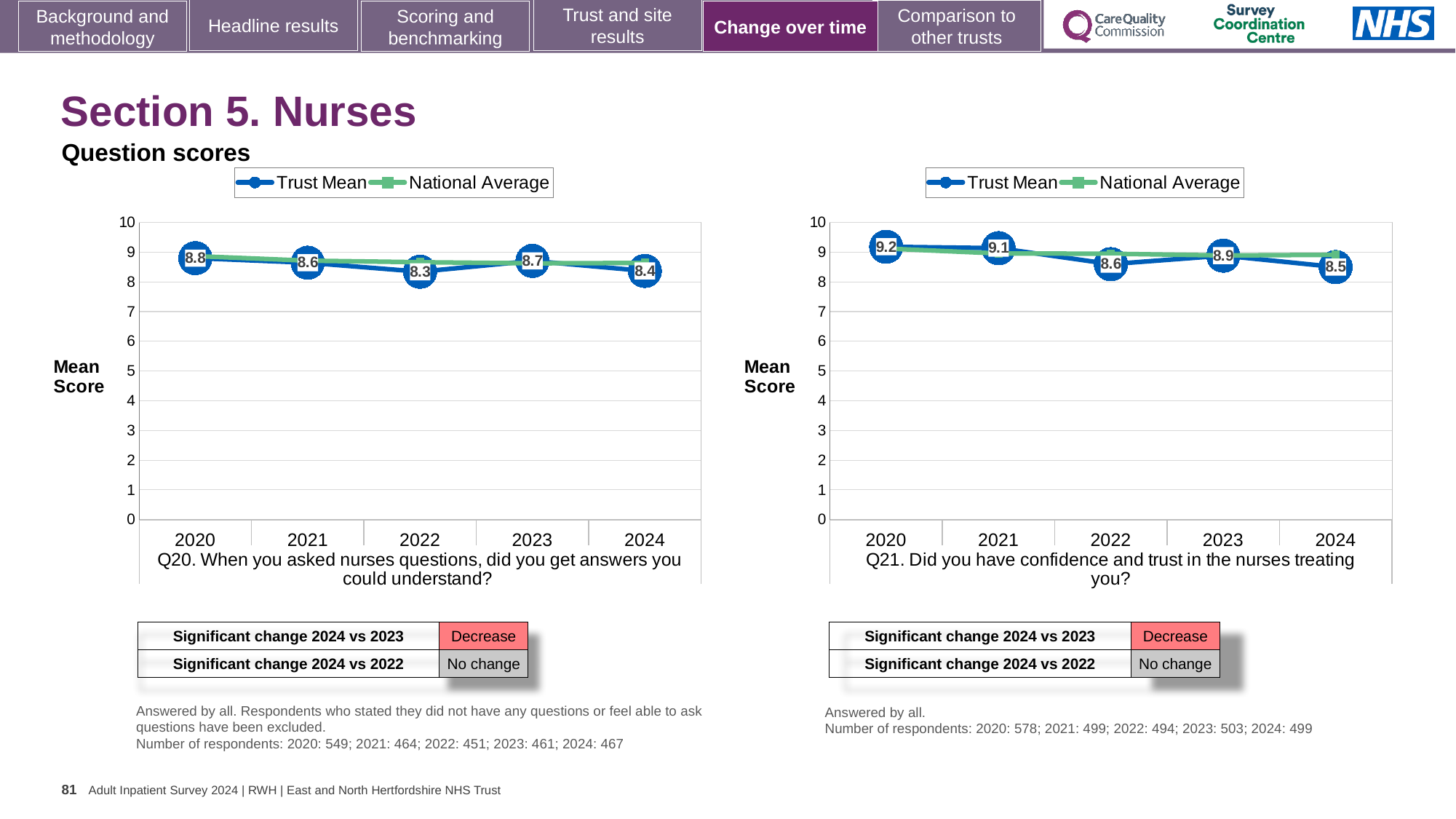
On the Q20 chart, which year has the highest Trust Mean score? 2020 On the Q21 chart, what is the Trust Mean score for 2020? 9.2 On the Q21 chart, is the Trust Mean score for 2021 larger or smaller than the score for 2023? larger On the Q21 chart, is the National Average value for 2024 greater or less than 8? greater How many series does the legend of the Q20 chart list? 2 On the Q20 chart, what is the difference between the Trust Mean scores for 2023 and 2024? 0.3 On the Q20 chart, which year has the lowest Trust Mean score? 2022 On the Q21 chart, which year has the lowest Trust Mean score? 2024 What type of chart is used for Q20? Line chart How many years are plotted on the Q21 chart? 5 On the Q20 chart, what is the Trust Mean score for 2024? 8.4 On the Q20 chart, what is the Trust Mean score for 2022? 8.3